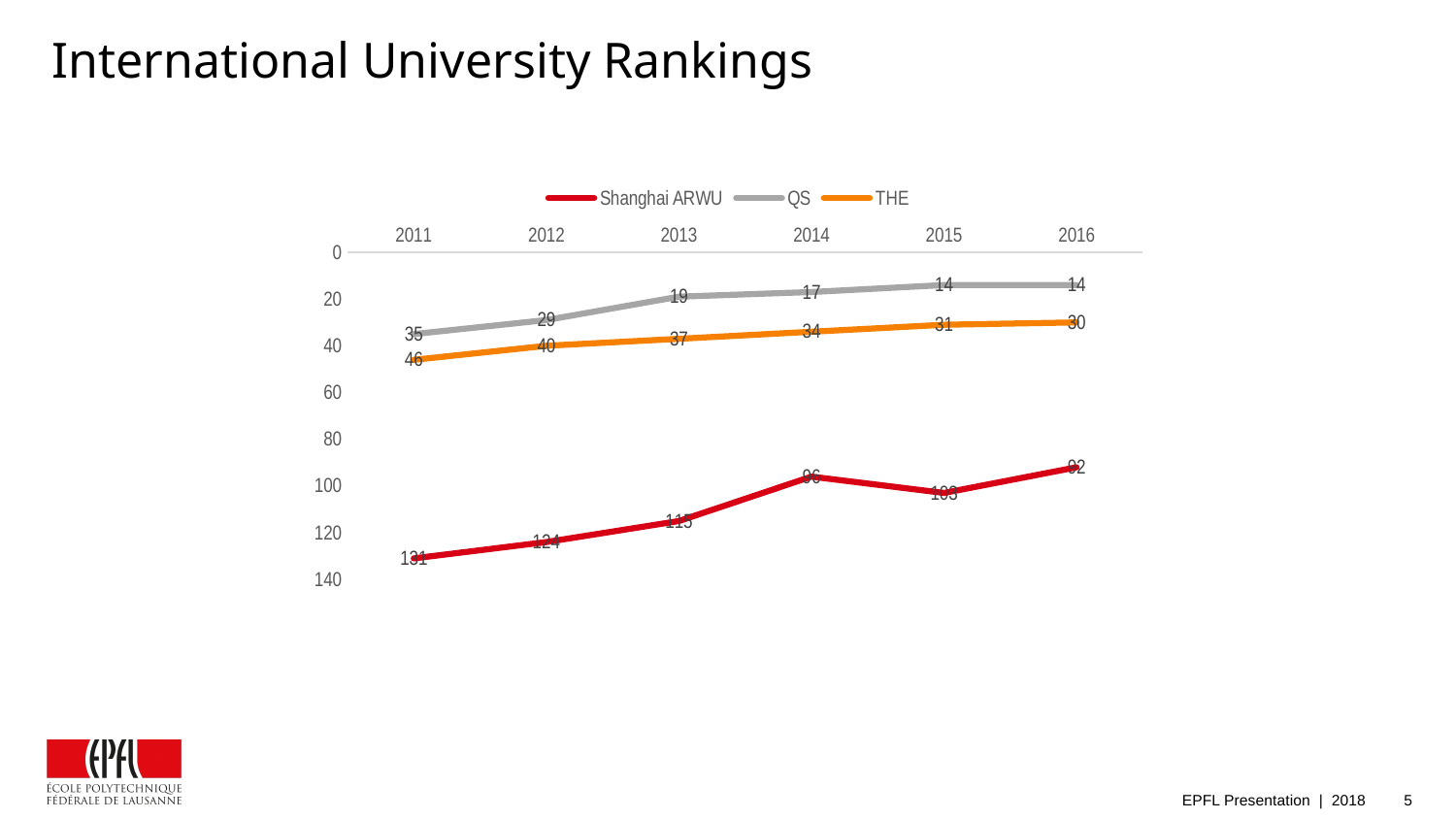
Do the QS values rise or fall from 2011 to 2016? fall What is the QS value for 2011? 35 How many years are shown on the x axis? 6 What is the THE value for 2016? 30 What is the difference between the THE value in 2011 and the THE value in 2016? 16 What kind of chart is shown on the slide? line chart In which year is the THE value highest? 2011 How many series does the legend list? 3 Is the Shanghai ARWU value for 2011 greater or less than 120? greater In 2014, which series has the larger value, QS or THE? THE What is the QS value for 2013? 19 What is the THE value for 2012? 40